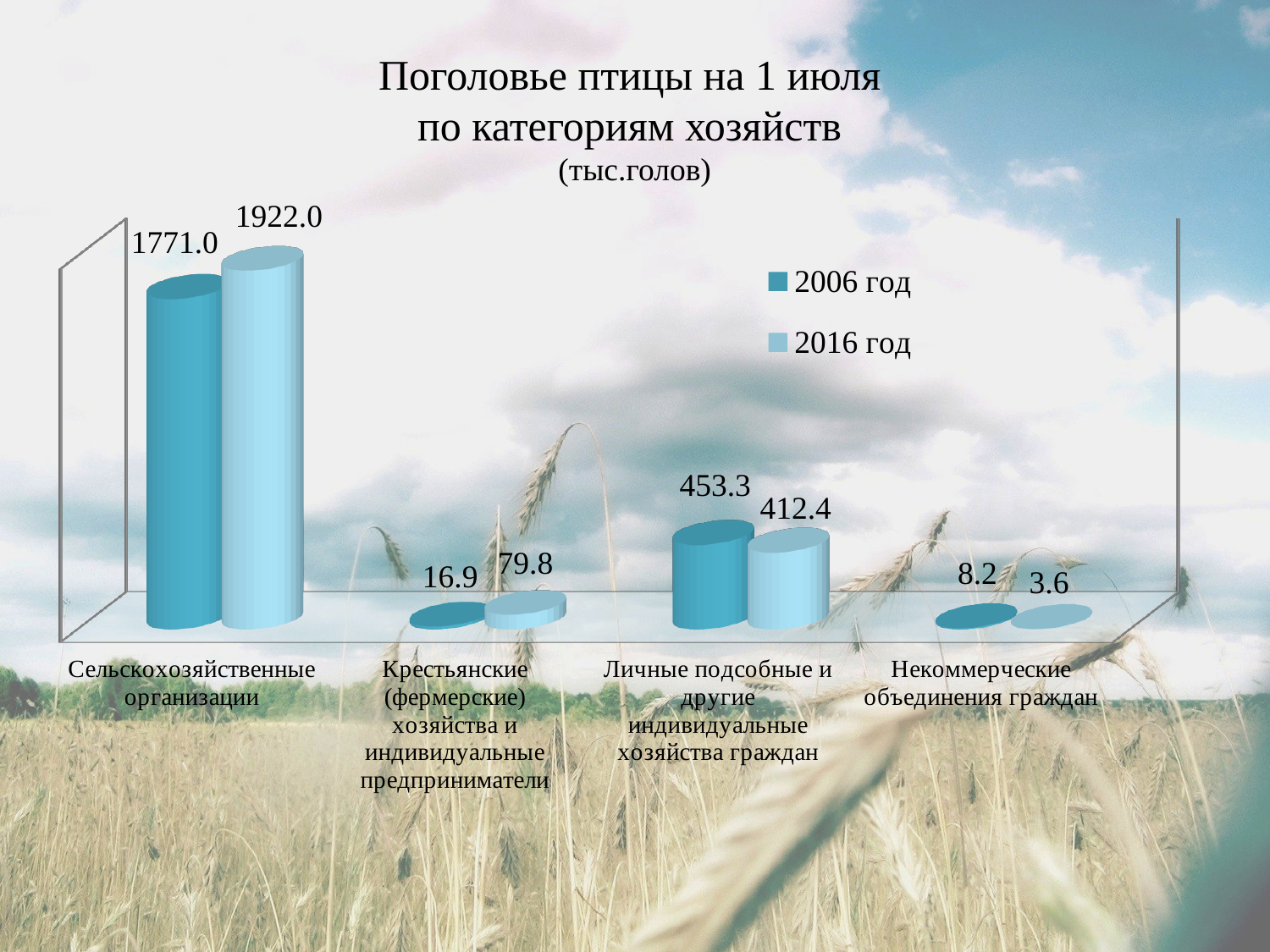
What is the value for Некоммерческие объединения граждан in 2006 год? 8.2 What is the value for Крестьянские (фермерские) хозяйства и индивидуальные предприниматели in 2006 год? 16.9 What is the value for Сельскохозяйственные организации in 2016 год? 1922.0 How many categories are shown on the x axis? 4 How many series does the legend list? 2 What is the value for Личные подсобные и другие индивидуальные хозяйства граждан in 2016 год? 412.4 Which is larger for Крестьянские (фермерские) хозяйства и индивидуальные предприниматели: the 2006 год value or the 2016 год value? 2016 год What kind of chart is shown on the slide? Bar chart What is the difference between the 2016 год and 2006 год values for Сельскохозяйственные организации? 151.0 Which category has the lowest value in 2016 год? Некоммерческие объединения граждан Which category has the highest value in 2016 год? Сельскохозяйственные организации What is the difference between the 2006 год and 2016 год values for Личные подсобные и другие индивидуальные хозяйства граждан? 40.9